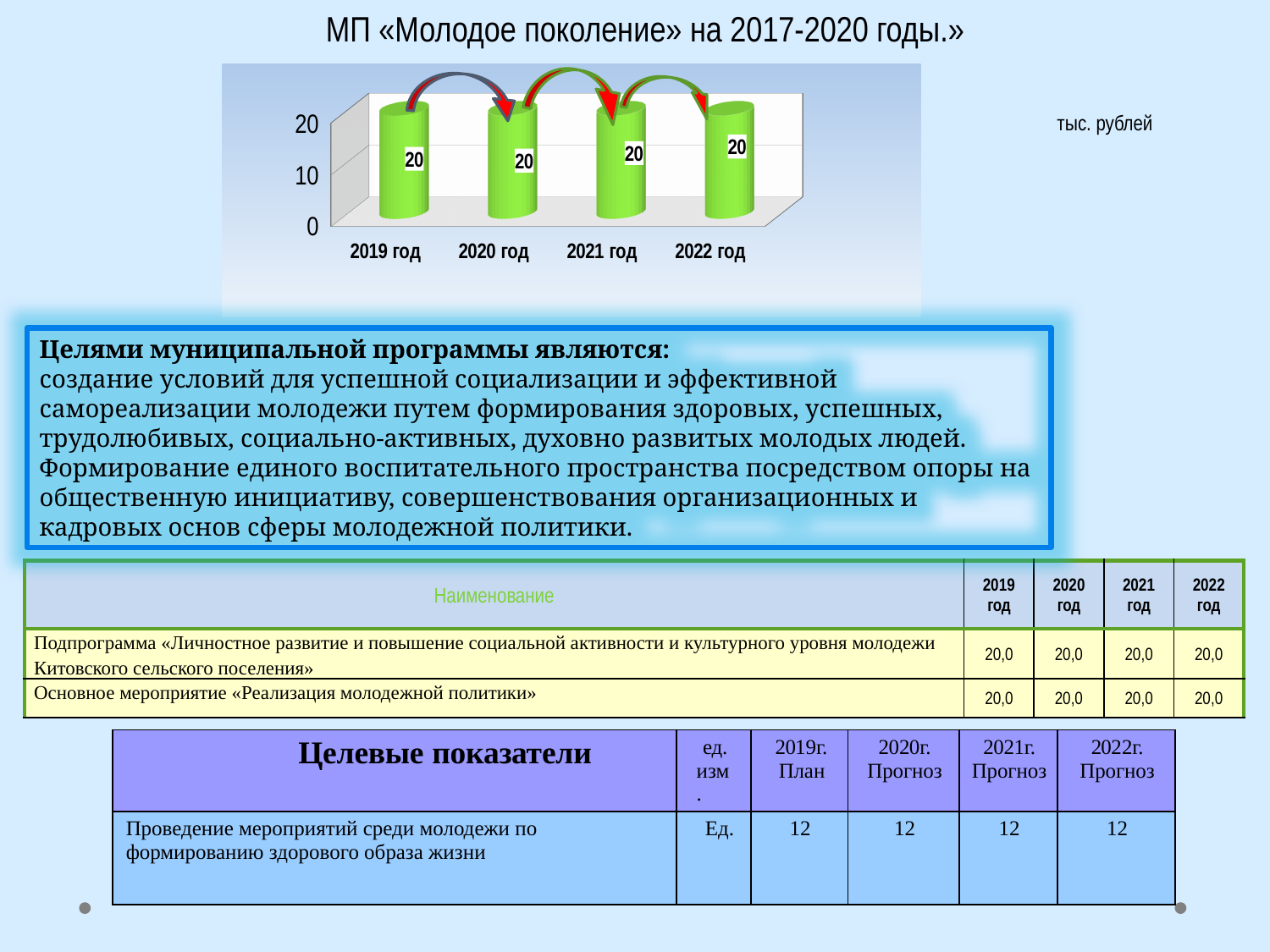
What is the value for 2022 год in the chart? 20 What is the value for 2019 год in the chart? 20 What is the difference between the values for 2022 год and 2019 год? 0 Are the values for 2020 год and 2021 год equal or different? equal Is the value for 2021 год greater or less than 10? greater What is the highest tick value shown on the vertical axis of the chart? 20 What is the value for 2021 год in the chart? 20 What kind of chart is shown on the slide? bar chart How many categories (years) are shown on the x axis of the chart? 4 Do the values rise, fall, or stay the same from 2019 год to 2022 год? stay the same What is the value for 2020 год in the chart? 20 What unit label is shown next to the chart? тыс. рублей